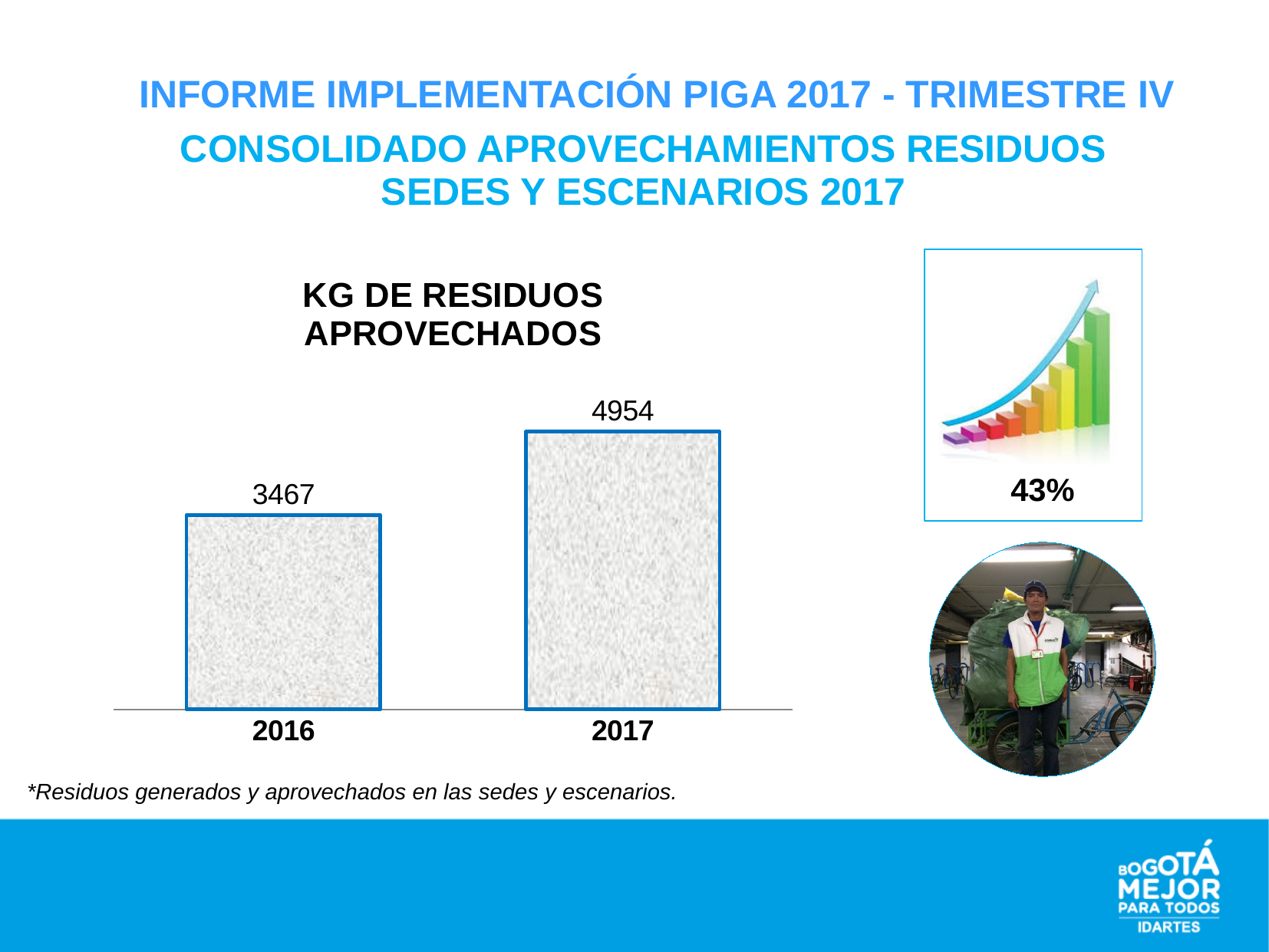
How many categories are shown in the chart? 2 What is the value for 2017 in the KG DE RESIDUOS APROVECHADOS chart? 4954 What is the difference between the 2017 and 2016 values in the chart? 1487 What is the title of the chart? KG DE RESIDUOS APROVECHADOS Which year has the lowest value in the chart? 2016 What is the value for 2016 in the KG DE RESIDUOS APROVECHADOS chart? 3467 Which is larger, the value for 2016 or the value for 2017? 2017 What percentage is shown in the box to the right of the chart? 43% Do the values rise or fall from 2016 to 2017? rise Which year has the highest value in the chart? 2017 What kind of chart is shown on the slide? bar chart